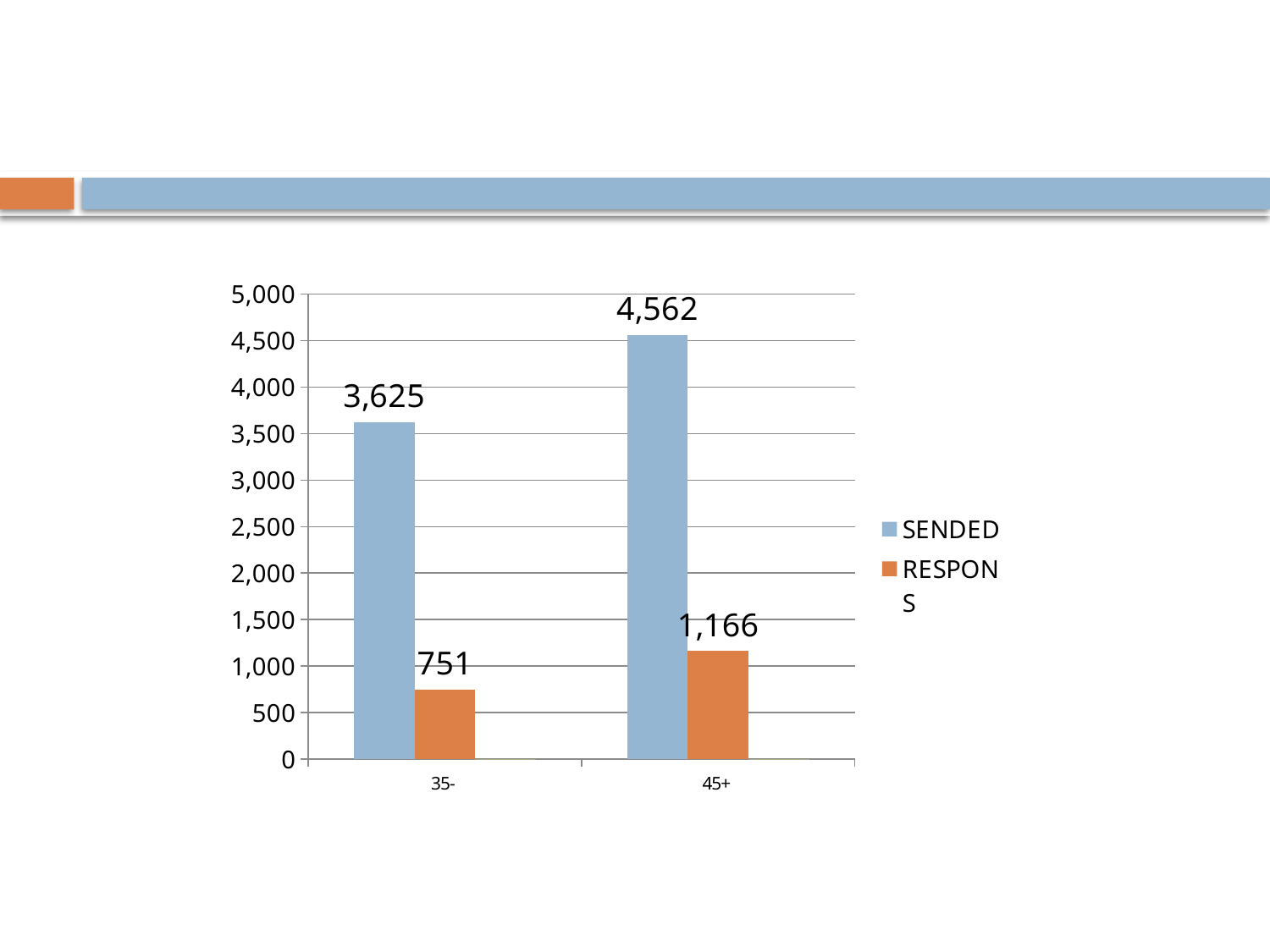
Which category has the lower RESPONS value? 35- What kind of chart is shown on the slide? bar chart Is the RESPONS value for 45+ larger or smaller than the RESPONS value for 35-? larger How many series does the legend list? 2 What is the difference between the SENDED values for 45+ and 35-? 937 What is the SENDED value for the 35- category? 3,625 What is the RESPONS value for the 35- category? 751 What is the difference between SENDED and RESPONS for the 35- category? 2,874 What is the SENDED value for the 45+ category? 4,562 What is the RESPONS value for the 45+ category? 1,166 How many categories are shown on the x axis? 2 Which category has the higher SENDED value? 45+